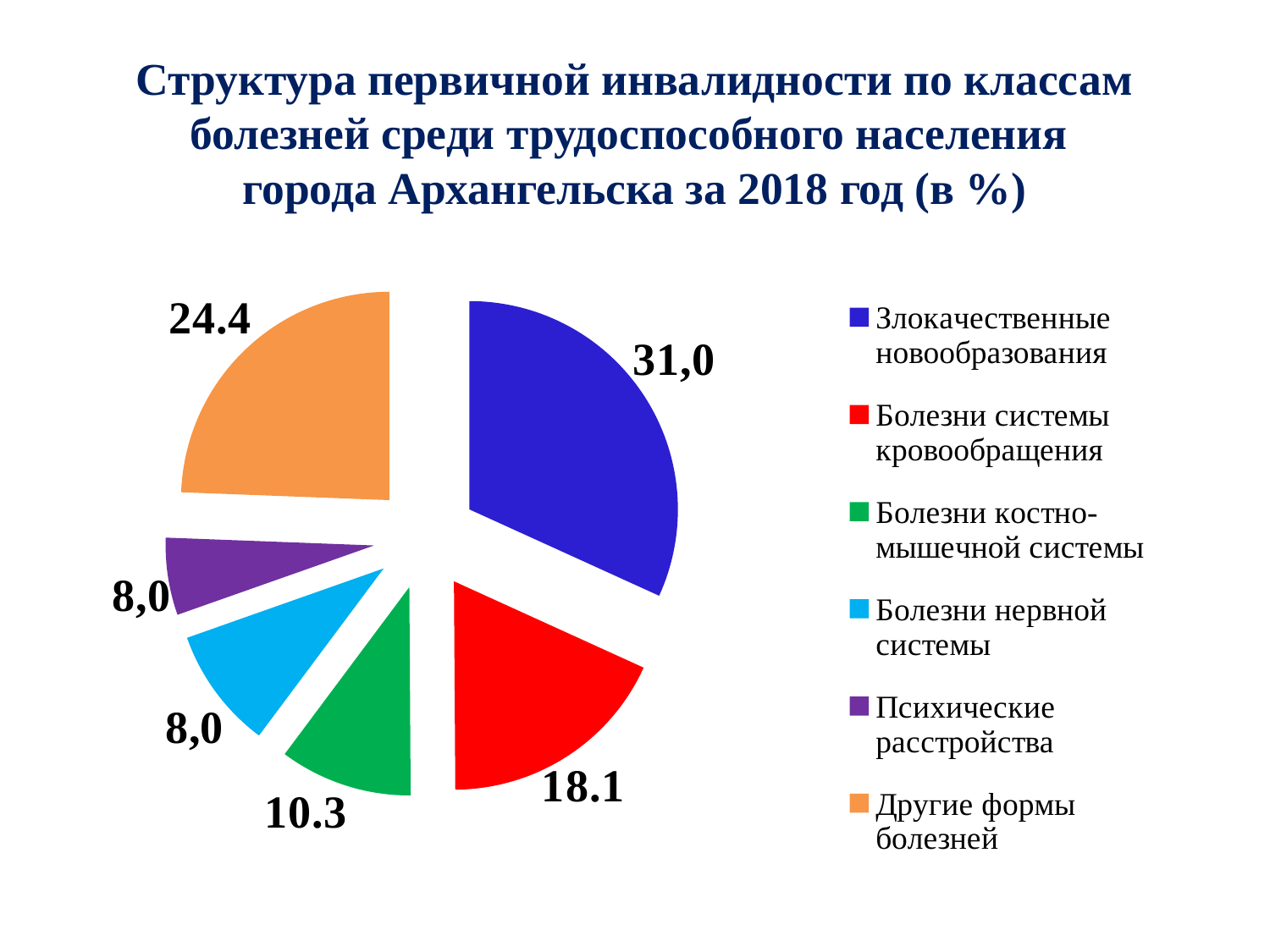
What colour is the slice for Болезни нервной системы? Light blue What is the value for Психические расстройства? 8,0 What type of chart is shown on the slide? Pie chart How many entries does the legend list? 6 What is the value for Злокачественные новообразования? 31,0 Which is larger: Другие формы болезней or Болезни костно-мышечной системы? Другие формы болезней How many slices does the pie chart have? 6 What is the value for Другие формы болезней? 24.4 What is the difference between the values for Злокачественные новообразования and Болезни системы кровообращения? 12.9 What is the value for Болезни системы кровообращения? 18.1 What is the value for Болезни костно-мышечной системы? 10.3 Which category has the largest slice of the pie? Злокачественные новообразования